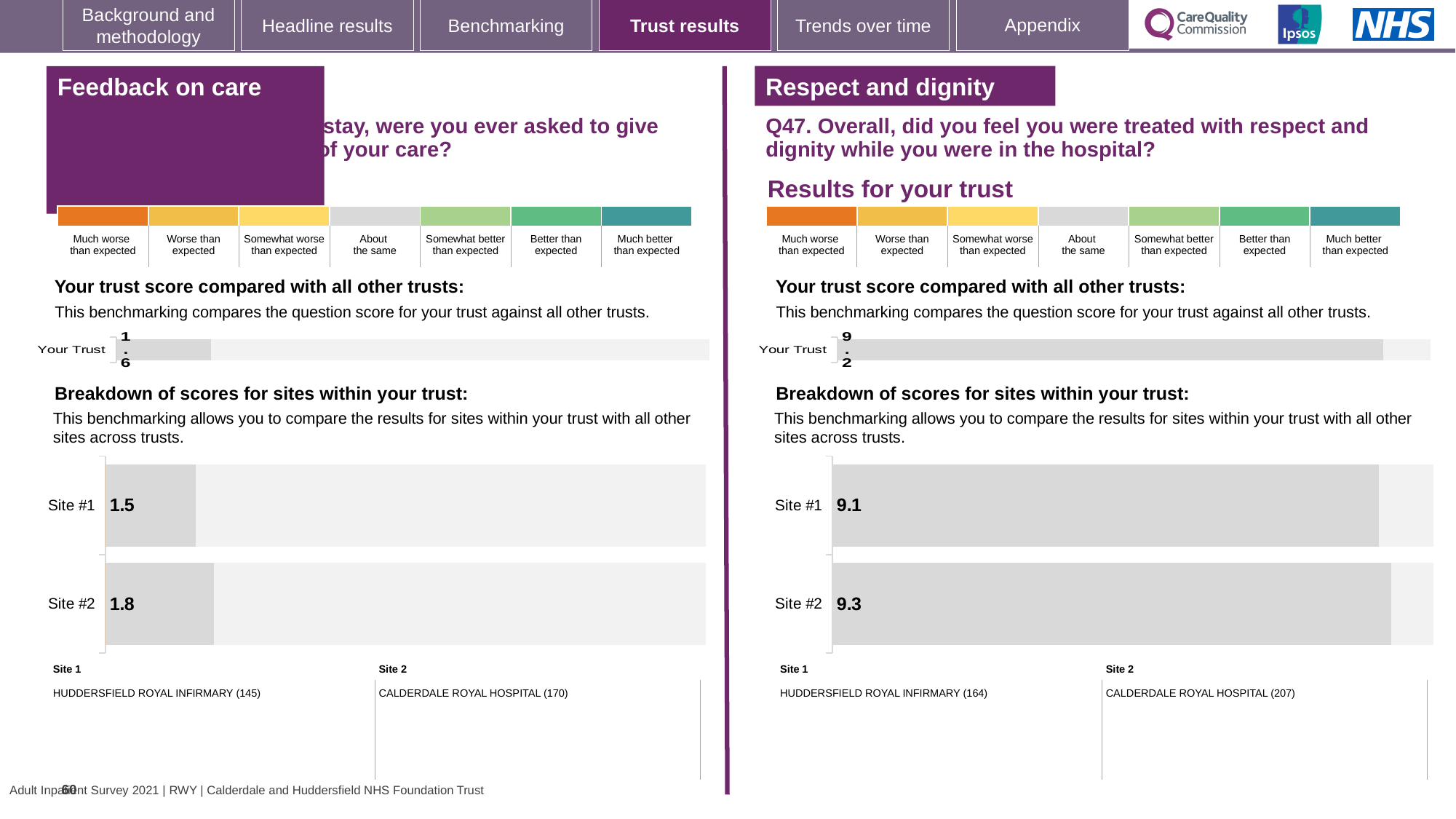
In the 'Respect and dignity' site breakdown chart, what is the score for Site #2? 9.3 In the 'Respect and dignity' section, what is the score shown for Your Trust in the trust comparison chart? 9.2 In the 'Feedback on care' section, what is the score shown for Your Trust in the trust comparison chart? 1.6 What type of chart is used for the site breakdown in the 'Feedback on care' section? Bar chart In the 'Feedback on care' site breakdown chart, what is the score for Site #2? 1.8 How many sites are shown in the 'Respect and dignity' site breakdown chart? 2 In the 'Feedback on care' site breakdown chart, what is the difference between the Site #2 and Site #1 scores? 0.3 In the 'Feedback on care' site breakdown chart, which site has the higher score? Site #2 In the 'Respect and dignity' site breakdown chart, which site has the lower score? Site #1 In the 'Feedback on care' site breakdown chart, what is the score for Site #1? 1.5 In the 'Respect and dignity' site breakdown chart, what is the difference between the Site #2 and Site #1 scores? 0.2 In the 'Respect and dignity' site breakdown chart, what is the score for Site #1? 9.1